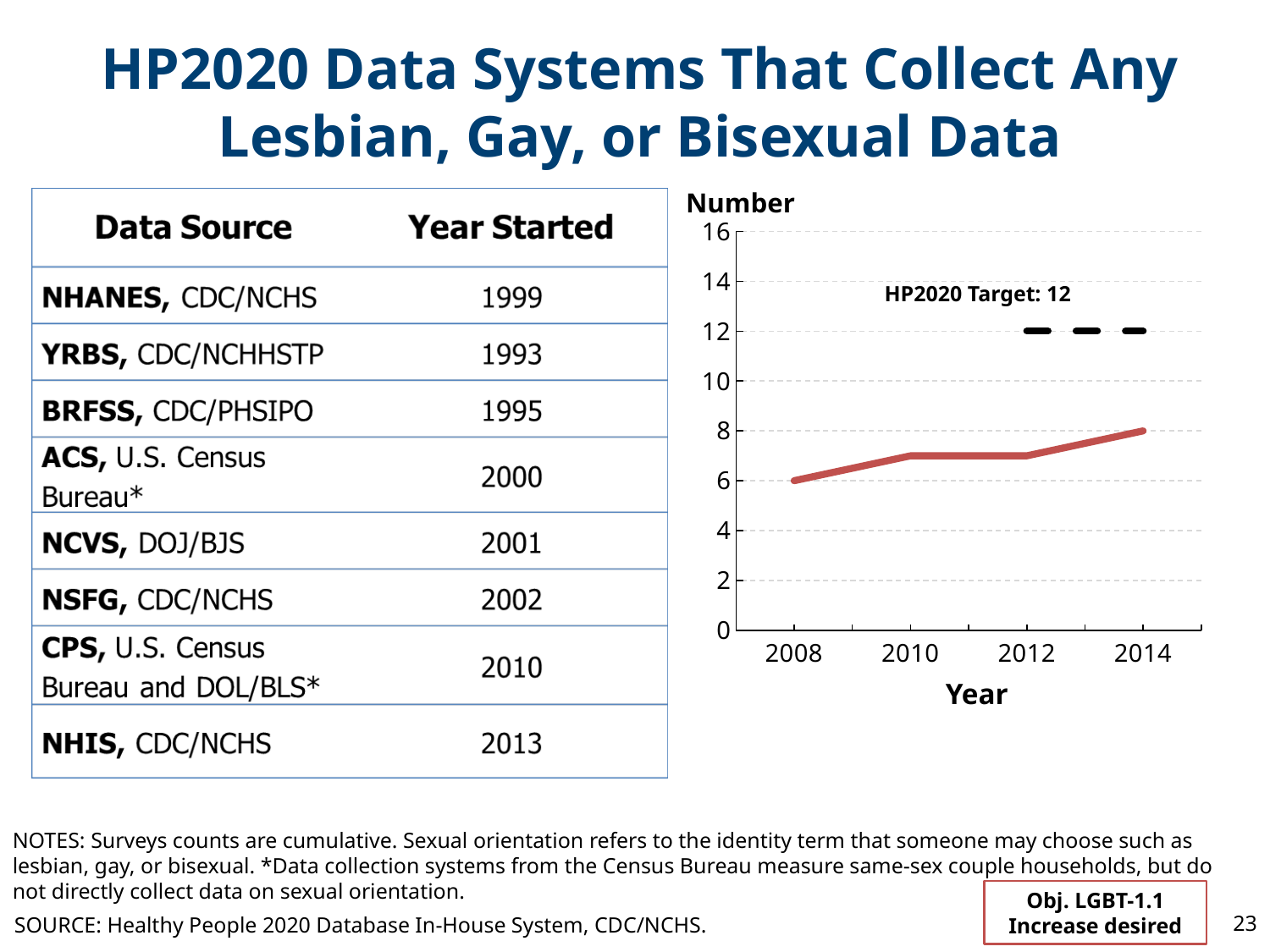
Which year has the highest number of data systems? 2014 What is the number of data systems in 2014? 8 Is the value for 2010 greater or less than 6? greater Which year has the lowest number of data systems? 2008 What is the HP2020 target value shown on the chart? 12 Which is larger, the value for 2008 or the value for 2014? 2014 What kind of chart is shown on the slide? line chart Is the value for 2012 greater or less than 10? less Does the number of data systems rise or fall from 2008 to 2014? rise What is the number of data systems in 2008? 6 What is the difference between the value for 2014 and the value for 2008? 2 What is the label of the x axis? Year